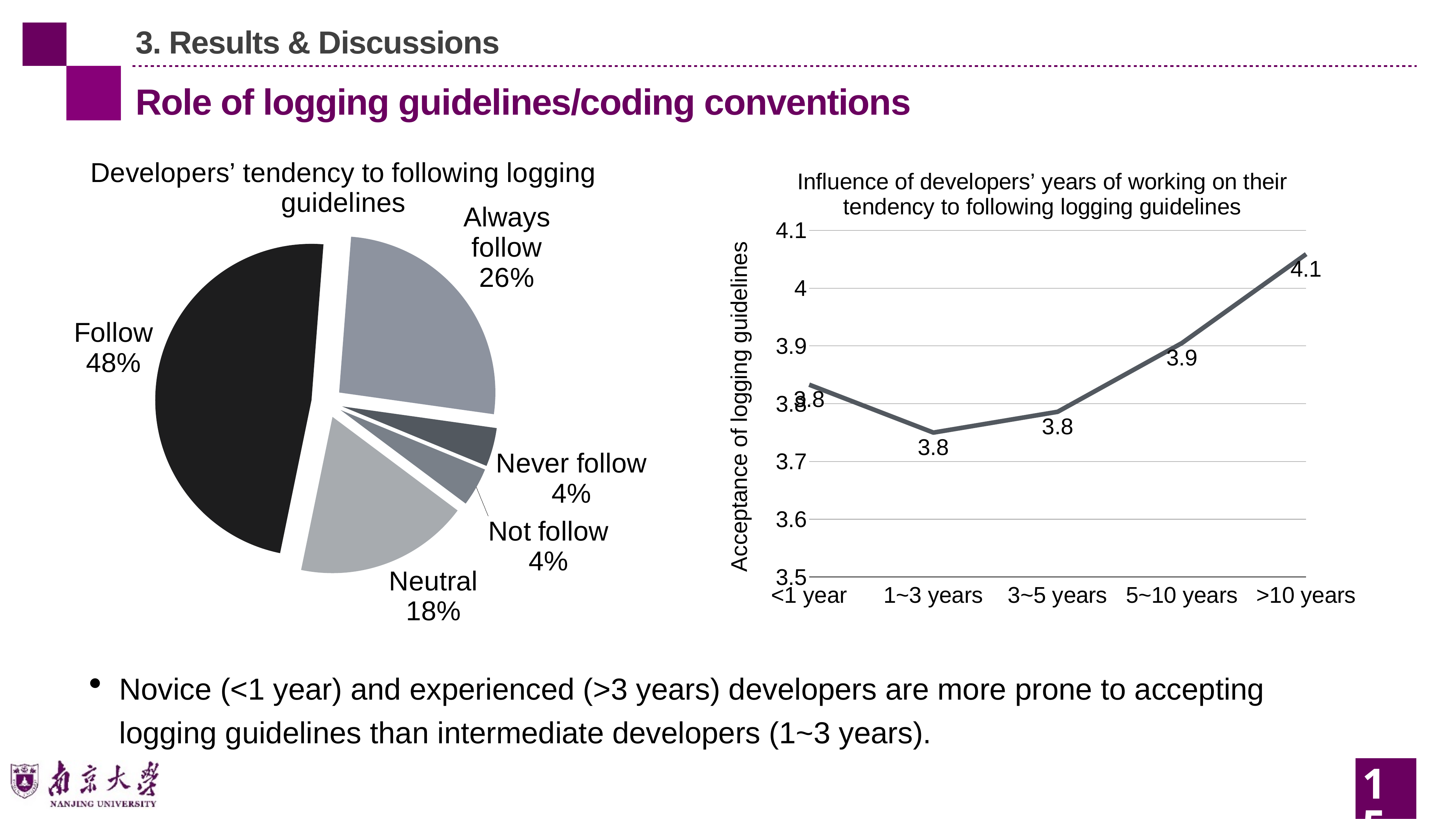
In the pie chart 'Developers' tendency to following logging guidelines', how many slices are there? 5 What kind of chart is the chart on the left of the slide? Pie chart In the line chart 'Influence of developers' years of working on their tendency to following logging guidelines', what is the difference between the values for '>10 years' and '5~10 years'? 0.2 In the line chart 'Influence of developers' years of working on their tendency to following logging guidelines', which experience group has the highest acceptance of logging guidelines? >10 years In the pie chart 'Developers' tendency to following logging guidelines', which category has the largest slice? Follow In the pie chart 'Developers' tendency to following logging guidelines', what percentage is shown for 'Always follow'? 26% In the pie chart 'Developers' tendency to following logging guidelines', what share of developers answered 'Follow'? 48% In the line chart 'Influence of developers' years of working on their tendency to following logging guidelines', what is the value for '>10 years'? 4.1 In the line chart 'Influence of developers' years of working on their tendency to following logging guidelines', how many experience groups are plotted on the x axis? 5 In the pie chart 'Developers' tendency to following logging guidelines', which is larger, 'Neutral' or 'Not follow'? Neutral In the line chart 'Influence of developers' years of working on their tendency to following logging guidelines', what is the value for '5~10 years'? 3.9 In the pie chart 'Developers' tendency to following logging guidelines', what is the difference in percentage points between 'Follow' and 'Always follow'? 22%